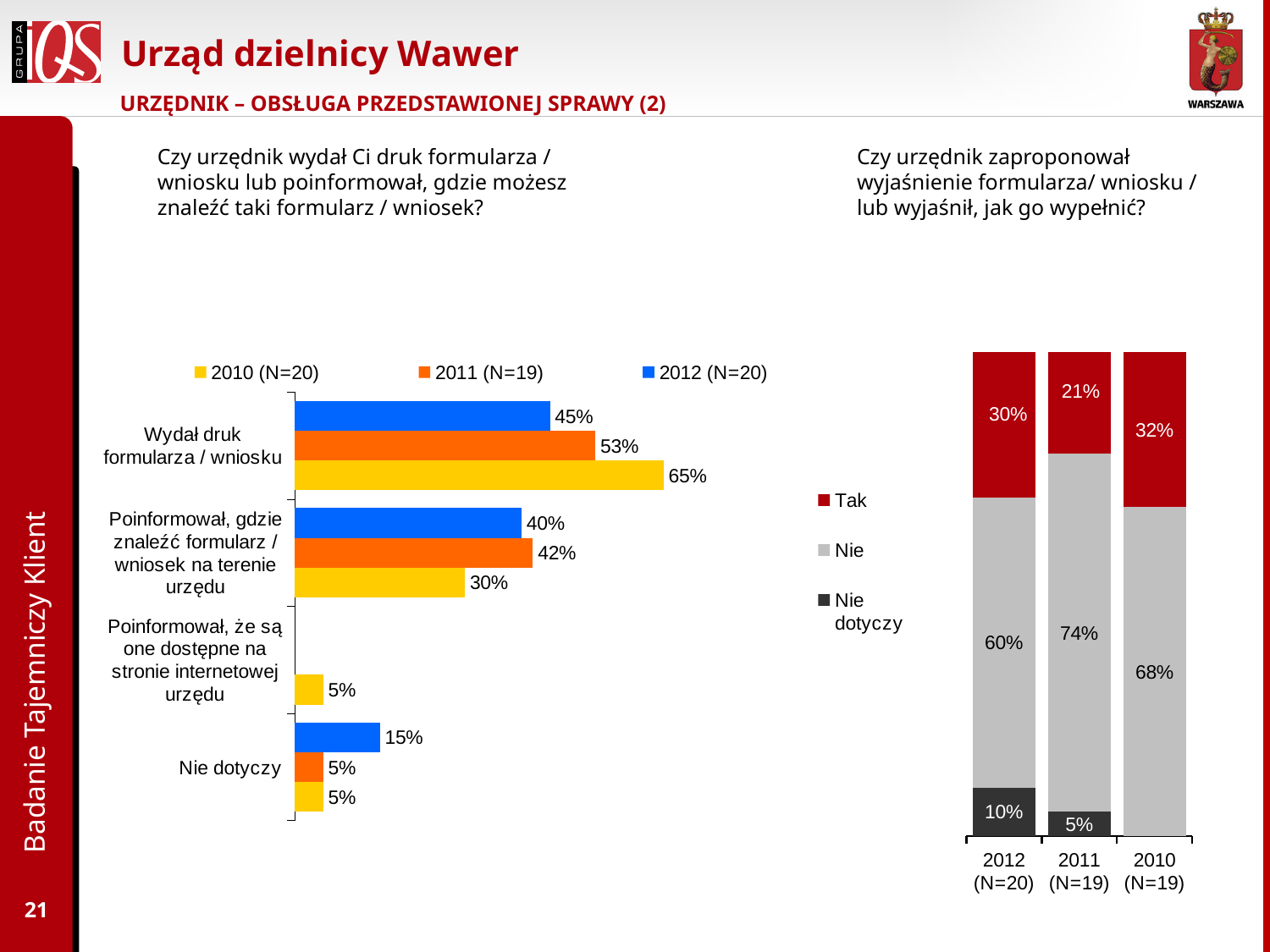
In the left chart, what is the value for 'Wydał druk formularza / wniosku' in the 2010 (N=20) series? 65% In the right chart, what is the 'Tak' value for 2011 (N=19)? 21% In the left chart, how many series does the legend list? 3 In the right chart, what is the total of the 2012 (N=20) stacked bar? 100% In the right chart, what is the 'Nie' value for 2010 (N=19)? 68% In the left chart, what is the value for 'Poinformował, gdzie znaleźć formularz / wniosek na terenie urzędu' in the 2011 (N=19) series? 42% In the left chart, which category has the highest value in the 2012 (N=20) series? Wydał druk formularza / wniosku In the right chart, which year has the highest 'Nie' value? 2011 (N=19) In the left chart, what is the difference between the 2010 and 2012 values for 'Wydał druk formularza / wniosku'? 20% In the left chart, what is the value for 'Nie dotyczy' in the 2012 (N=20) series? 15% In the left chart, how many categories are shown on the vertical axis? 4 What kind of chart is the chart on the right side of the slide? Stacked bar chart